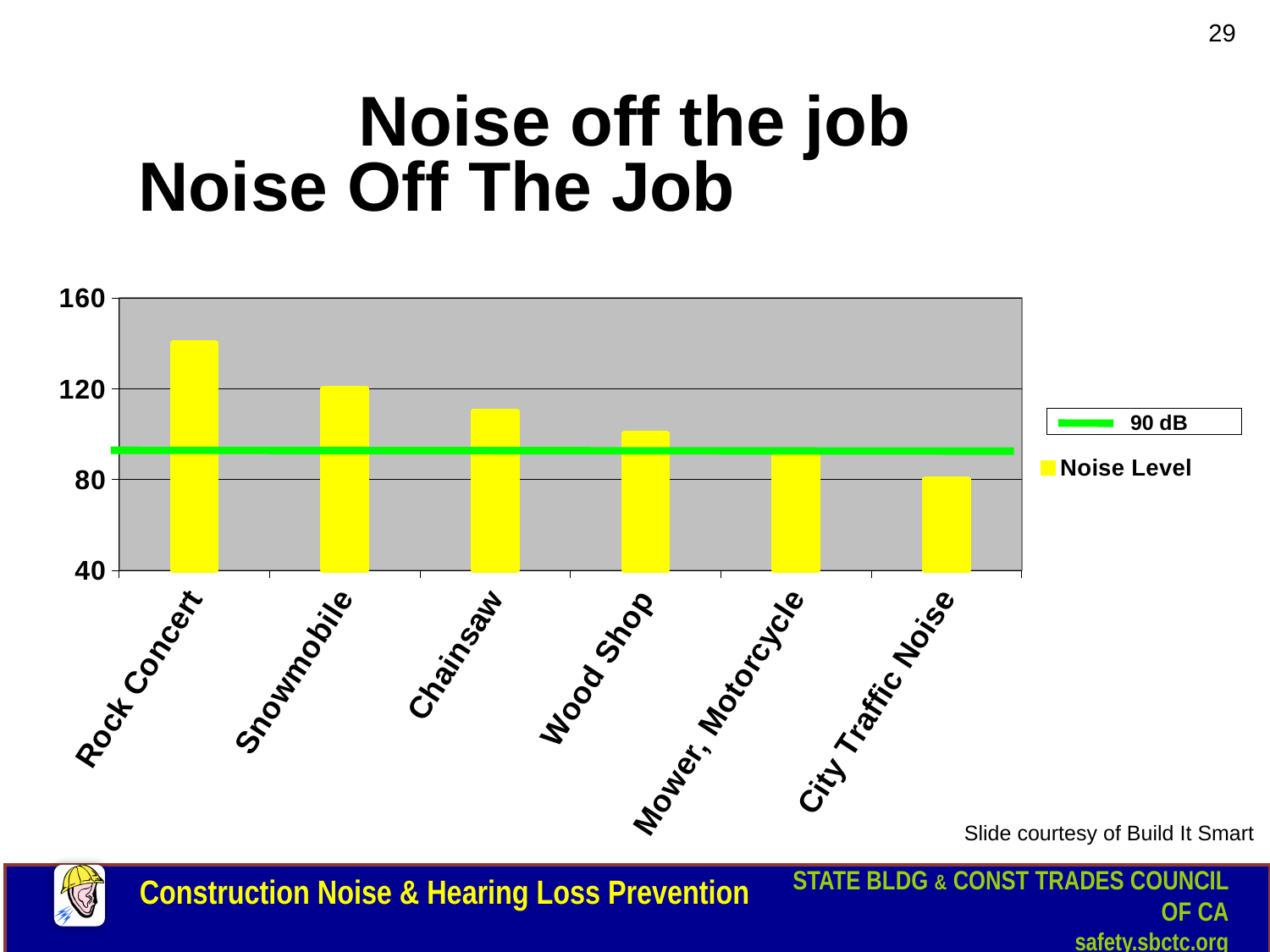
Is the value for Wood Shop greater or less than 80? greater Is the value for Rock Concert greater or less than 120? greater How many entries does the chart's legend list? 2 Which category has the lowest noise level? City Traffic Noise Is the value for Chainsaw greater or less than 120? less What level does the green horizontal line on the chart represent, according to the legend? 90 dB How many categories are plotted on the chart? 6 Do the noise levels rise or fall moving from left to right across the categories? fall Which category has the highest noise level? Rock Concert Which has a higher noise level, Rock Concert or Chainsaw? Rock Concert Which has a higher noise level, Wood Shop or City Traffic Noise? Wood Shop What kind of chart is shown on the slide? bar chart